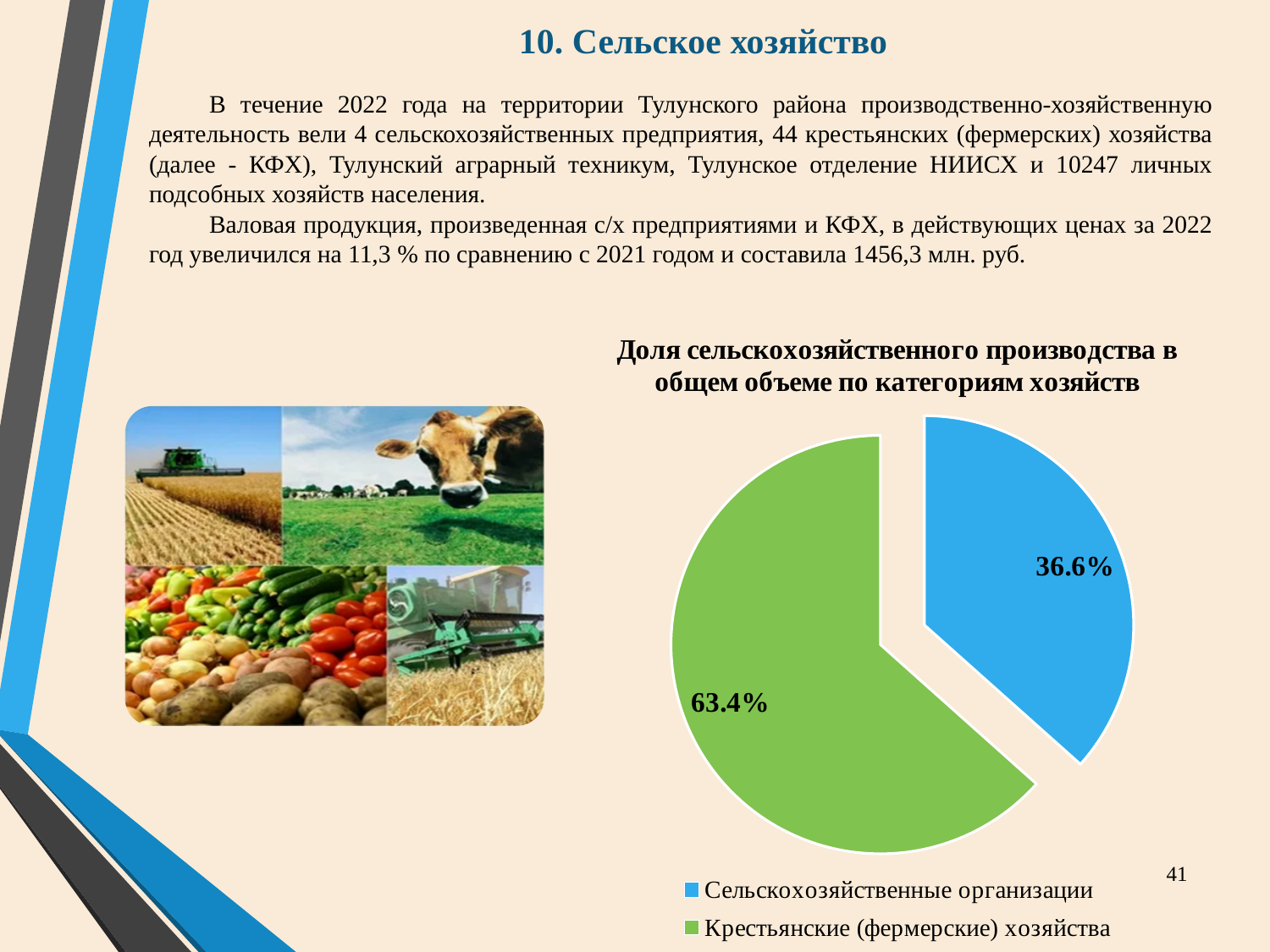
Which category has the largest share of the pie? Крестьянские (фермерские) хозяйства What is the share for Сельскохозяйственные организации? 36.6% Which category has the smallest share of the pie? Сельскохозяйственные организации What is the share for Крестьянские (фермерские) хозяйства? 63.4% How many entries does the legend list? 2 What colour is the slice for Сельскохозяйственные организации? blue What is the title of the pie chart? Доля сельскохозяйственного производства в общем объеме по категориям хозяйств What is the total of the two slices shown in the pie chart? 100% Which is larger: the share of Сельскохозяйственные организации or the share of Крестьянские (фермерские) хозяйства? Крестьянские (фермерские) хозяйства What is the difference in percentage points between the share of Крестьянские (фермерские) хозяйства and Сельскохозяйственные организации? 26.8 What kind of chart is shown on the slide? pie chart How many slices does the pie chart have? 2